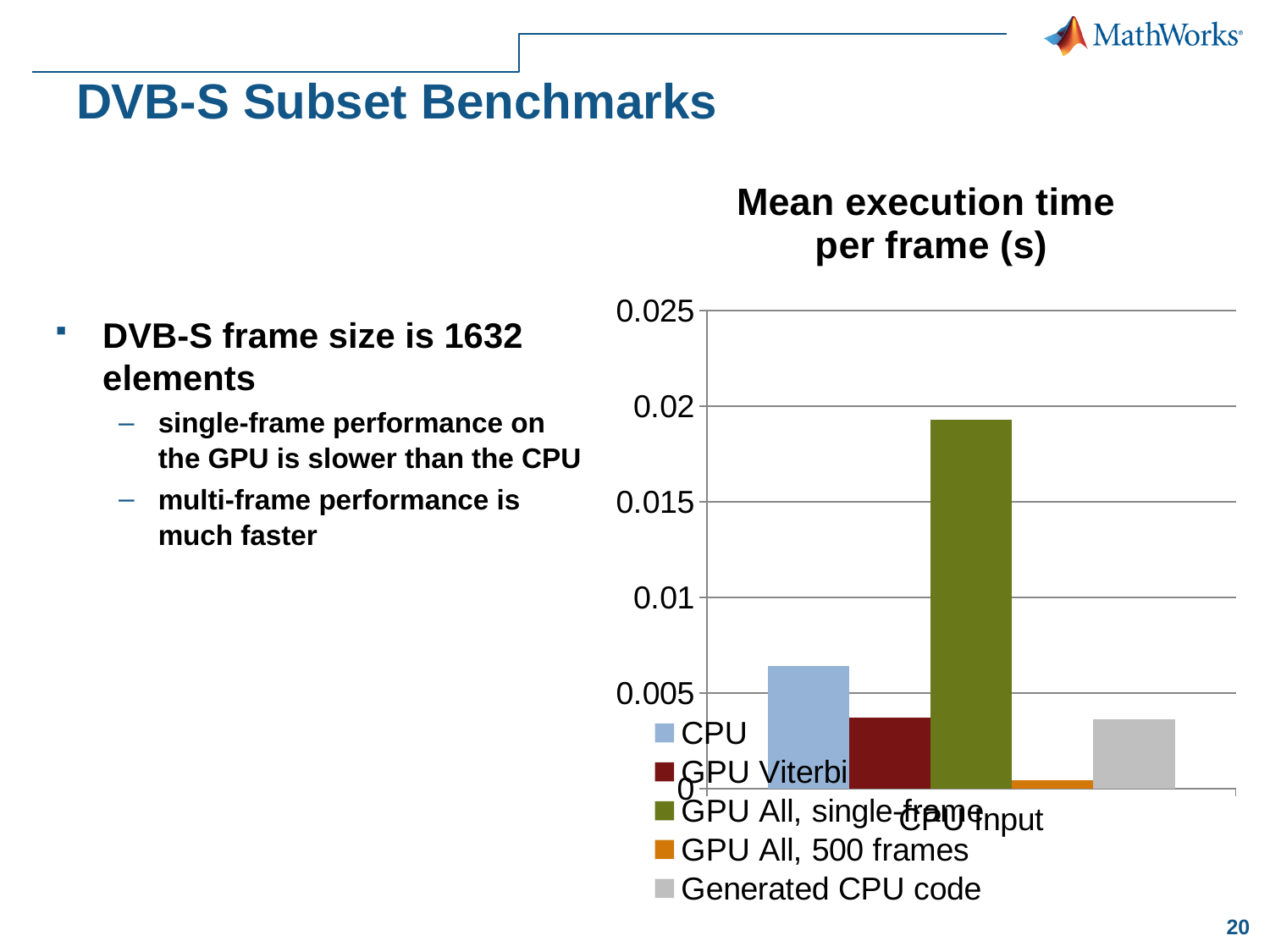
Which series has the highest mean execution time per frame? GPU All, single-frame Which is larger, the value for CPU or the value for GPU Viterbi? CPU What is the title of the chart? Mean execution time per frame (s) What type of chart is shown on the slide? bar chart Is the value for GPU Viterbi greater or less than 0.005? less Which colour represents the GPU All, single-frame series in the legend? green Is the value for GPU All, single-frame greater or less than 0.015? greater How many series does the chart legend list? 5 Which series has the lowest mean execution time per frame? GPU All, 500 frames Is the value for GPU All, 500 frames greater or less than 0.005? less How many categories are shown on the x axis of the chart? 1